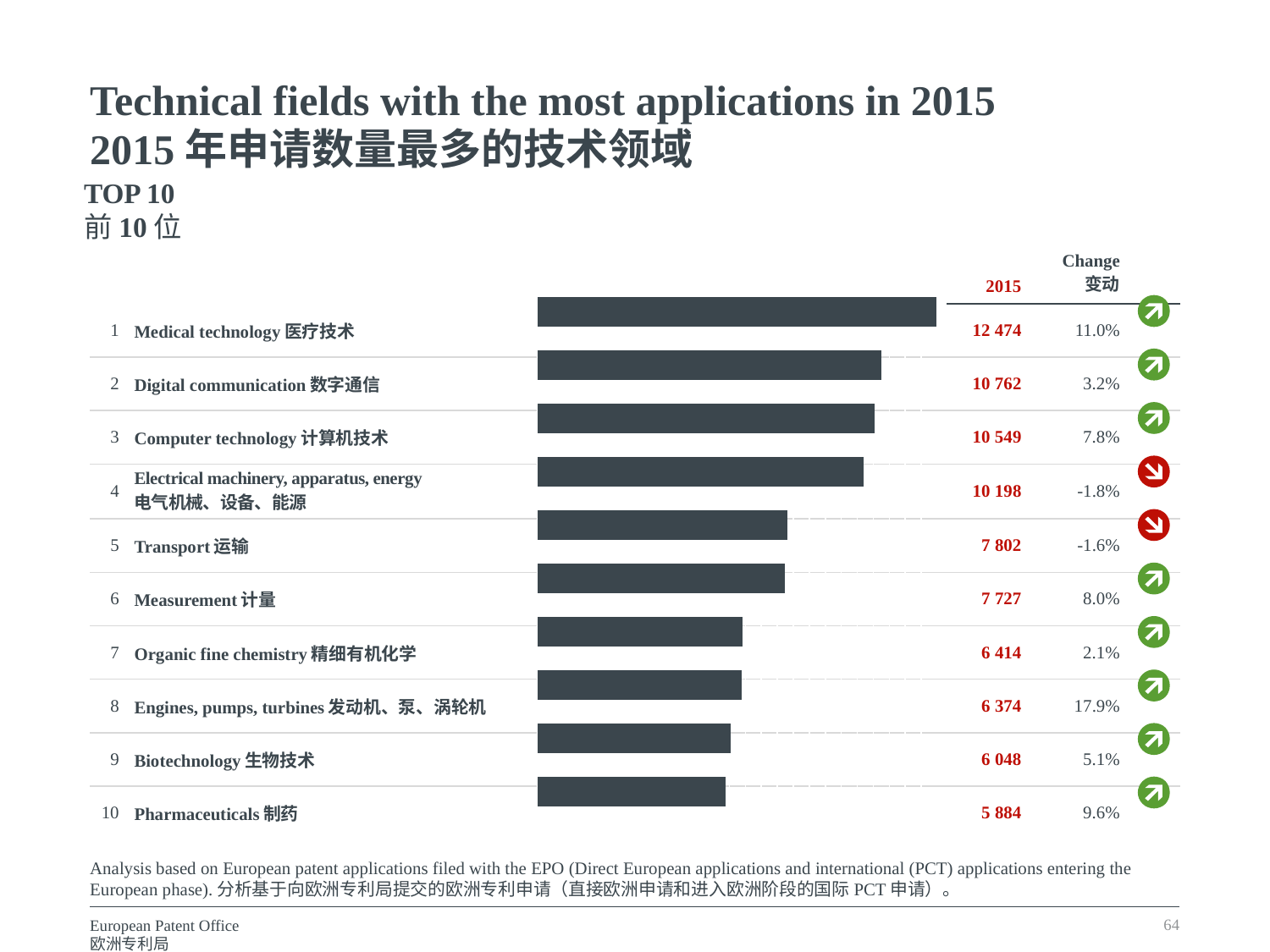
What was the change for Engines, pumps, turbines? 17.9% Which technical field had the most applications in 2015? Medical technology Which technical field among the top 10 had the fewest applications in 2015? Pharmaceuticals What was the change for Electrical machinery, apparatus, energy? -1.8% What is the difference in 2015 applications between Biotechnology and Pharmaceuticals? 164 What kind of chart is shown on the slide? bar chart What is the difference in 2015 applications between Medical technology and Digital communication? 1 712 Do the bar values rise or fall going from rank 1 down to rank 10? fall How many applications did Computer technology have in 2015? 10 549 Which had more applications in 2015, Medical technology or Transport? Medical technology How many applications did Medical technology have in 2015? 12 474 How many technical fields are shown in the chart? 10